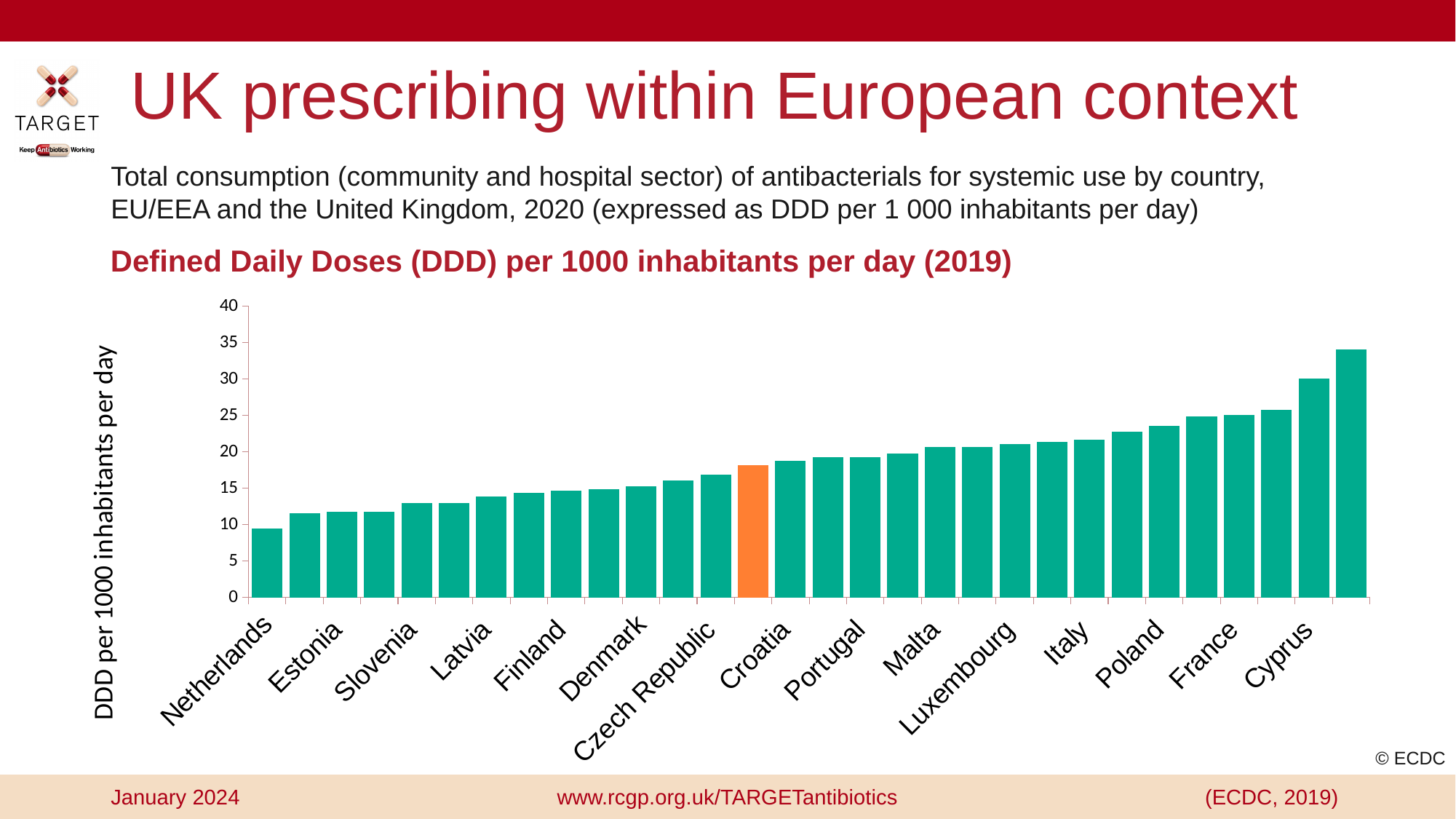
Is the value for Poland greater or less than 20? greater Is the value for Estonia greater or less than 10? greater Is the value for Portugal greater or less than 20? less Which has a higher value, Poland or Estonia? Poland How many country labels are shown on the x axis? 15 What kind of chart is shown on the slide? bar chart Do the bar values rise or fall from left to right along the x axis? rise Which labelled country has the lowest DDD per 1000 inhabitants per day? Netherlands What colour is the single highlighted bar that differs from the others? orange